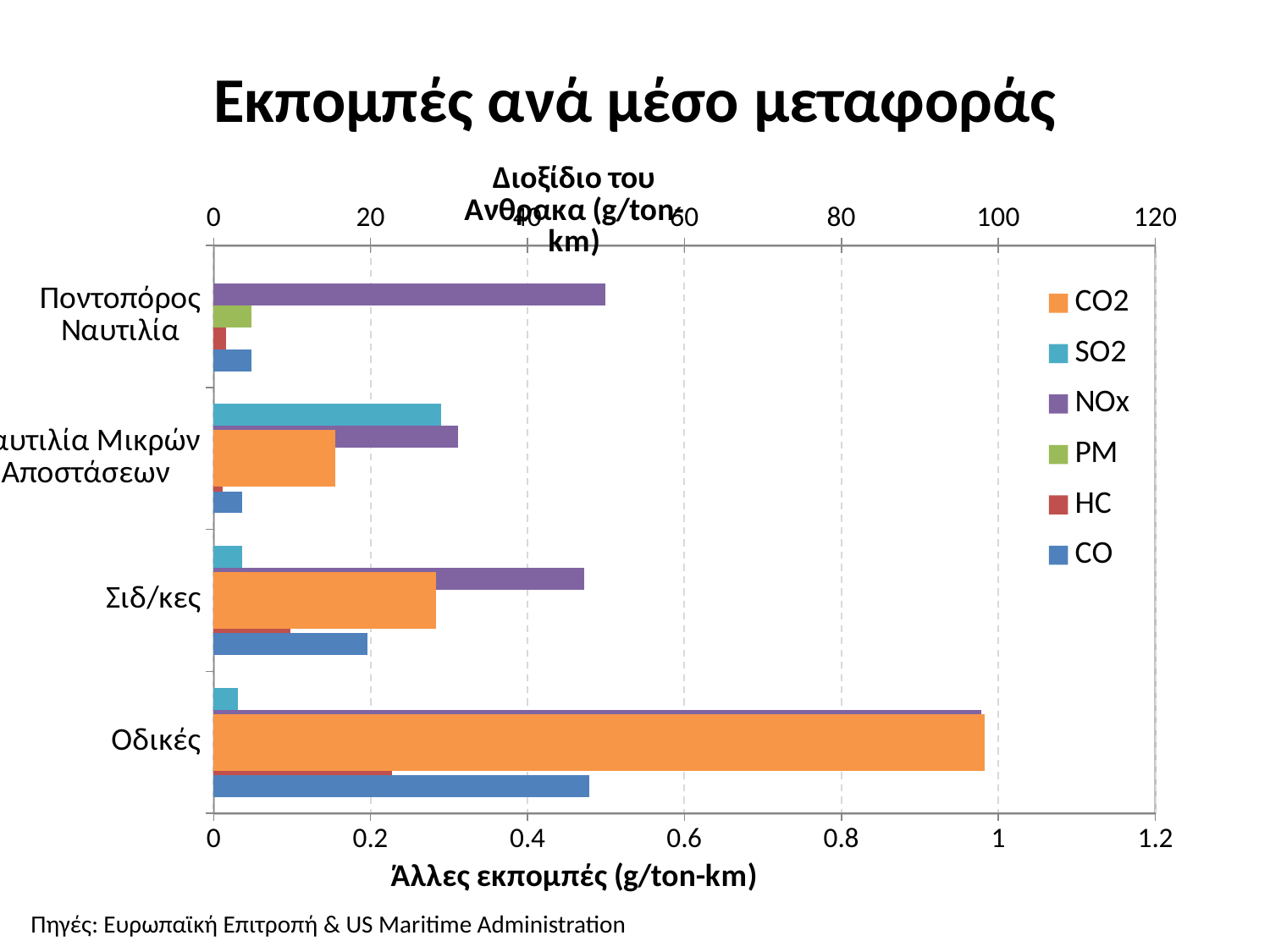
What is the title of the bottom horizontal axis? Άλλες εκπομπές (g/ton-km) What kind of chart is shown on the slide? Bar chart Is the CO value for Οδικές greater or less than 0.4 on the bottom axis? greater Is the CO2 value for Οδικές greater or less than 80 on the top axis? greater How many transport modes (categories) are shown on the chart? 4 Which has the larger CO2 value, Σιδ/κες or Ναυτιλία Μικρών Αποστάσεων? Σιδ/κες Is the NOx value for Ποντοπόρος Ναυτιλία greater or less than 0.4 on the bottom axis? greater Which transport mode has the highest CO2 emissions? Οδικές How many series does the legend list? 6 Which transport mode has the highest NOx emissions? Οδικές Which transport mode has the highest SO2 emissions? Ναυτιλία Μικρών Αποστάσεων